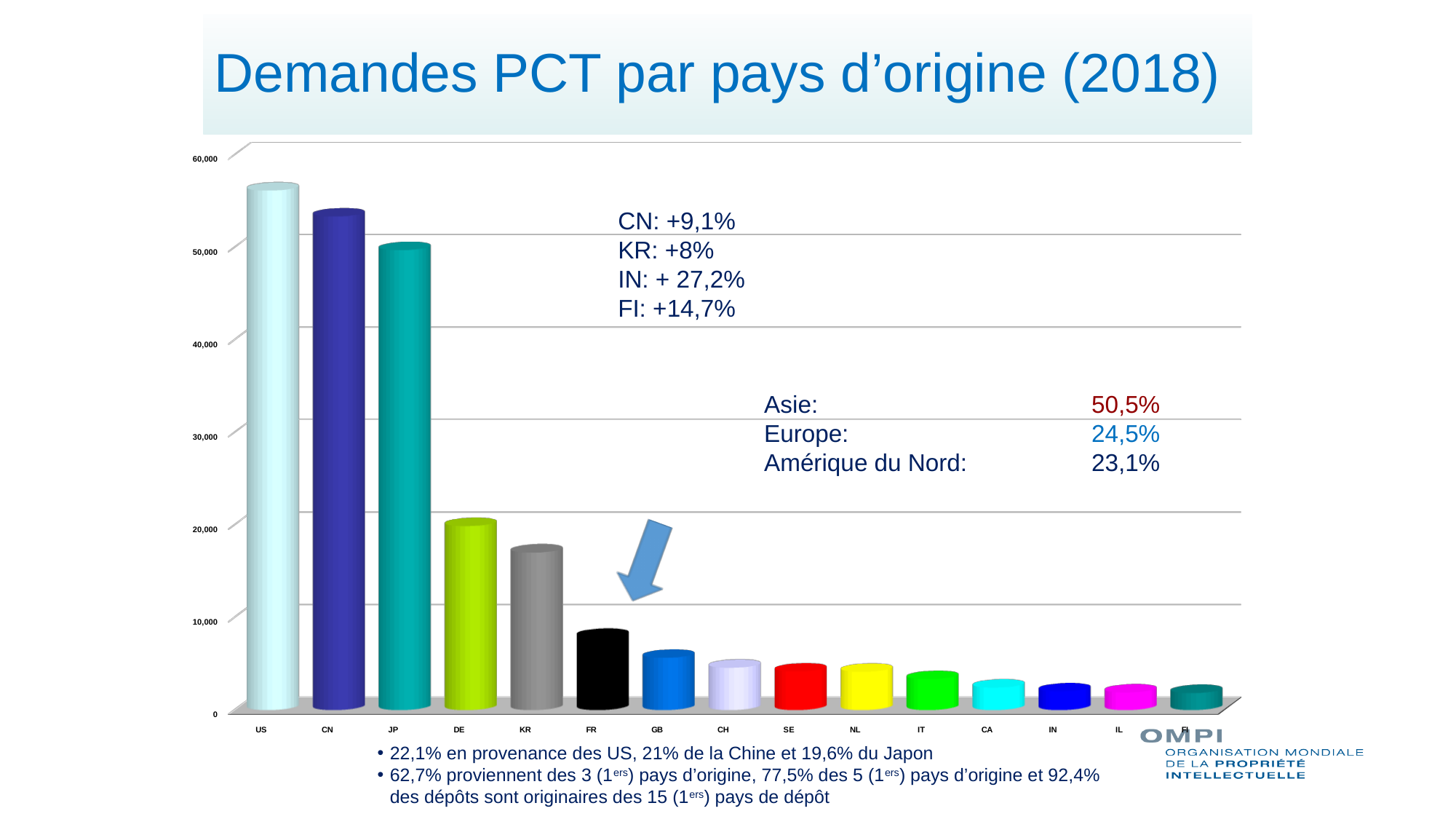
Is the value for KR greater or less than 10,000? greater Is the value for FR greater or less than 10,000? less Which is larger, the value for FR or the value for GB? FR What kind of chart is shown on the slide? bar chart What is the title of the slide containing the chart? Demandes PCT par pays d’origine (2018) Which is larger, the value for DE or the value for KR? DE Is the value for KR greater or less than 20,000? less Which country has the highest number of PCT applications in the chart? US Which is larger, the value for US or the value for CN? US Do the bar values rise or fall from left to right along the x axis? fall How many countries are plotted in the chart? 15